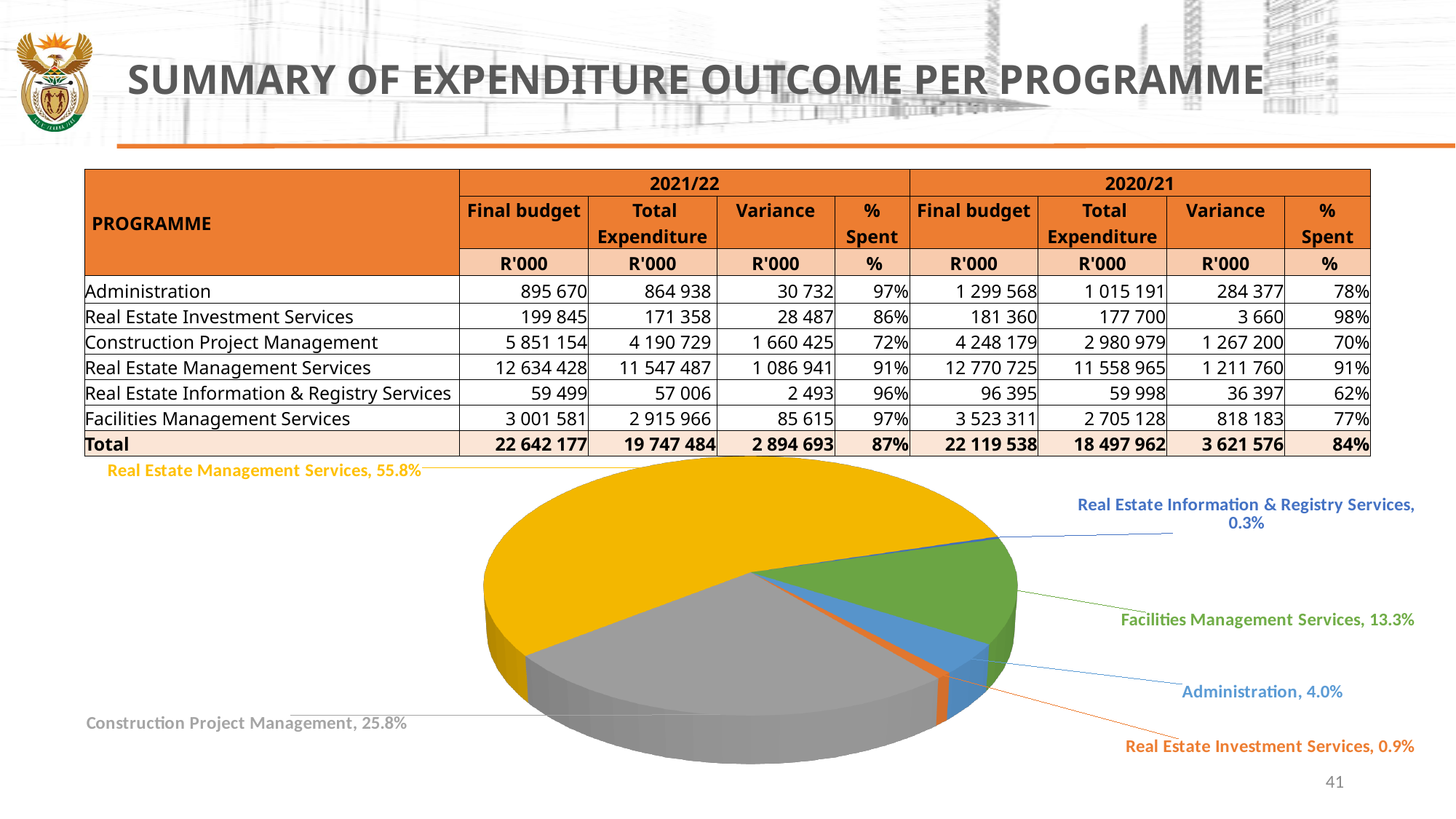
What share of the pie does Real Estate Management Services have? 55.8% What share of the pie does Real Estate Information & Registry Services have? 0.3% What share of the pie does Administration have? 4.0% How many slices does the pie chart have? 6 What kind of chart is shown on the slide? Pie chart Which slice of the pie chart is the smallest? Real Estate Information & Registry Services What is the difference in percentage points between the Real Estate Management Services slice and the Construction Project Management slice? 30.0 percentage points Which slice is larger, Facilities Management Services or Administration? Facilities Management Services Which slice of the pie chart is the largest? Real Estate Management Services